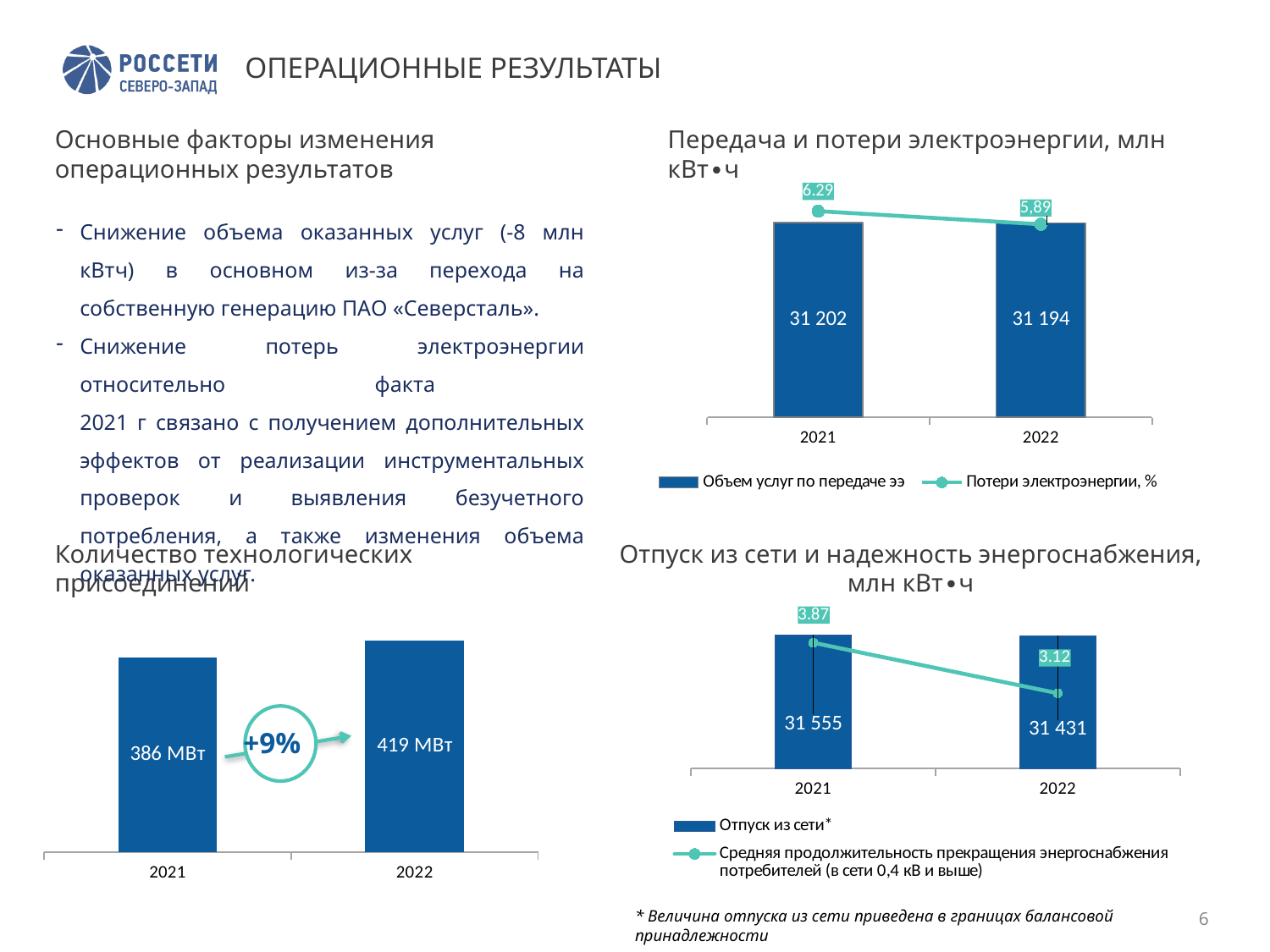
In the chart 'Количество технологических присоединений', which year has the higher value? 2022 What kind of chart is 'Количество технологических присоединений'? bar chart In the chart 'Количество технологических присоединений', what is the difference between the 2022 and 2021 values? 33 МВт In the chart 'Отпуск из сети и надежность энергоснабжения, млн кВт•ч', how many years are shown on the x axis? 2 In the chart 'Отпуск из сети и надежность энергоснабжения, млн кВт•ч', what is the value of the line series for 2022? 3.12 How many series does the legend of the chart 'Передача и потери электроэнергии, млн кВт•ч' list? 2 In the chart 'Отпуск из сети и надежность энергоснабжения, млн кВт•ч', what is the value of 'Отпуск из сети' for 2021? 31 555 In the chart 'Передача и потери электроэнергии, млн кВт•ч', what is the value of 'Потери электроэнергии, %' for 2021? 6.29 In the chart 'Передача и потери электроэнергии, млн кВт•ч', what is the value of 'Объем услуг по передаче ээ' for 2022? 31 194 In the chart 'Количество технологических присоединений', what is the value for 2021? 386 МВт In the chart 'Передача и потери электроэнергии, млн кВт•ч', does 'Потери электроэнергии, %' rise or fall from 2021 to 2022? fall In the chart 'Передача и потери электроэнергии, млн кВт•ч', by how much did 'Объем услуг по передаче ээ' change from 2021 to 2022? 8